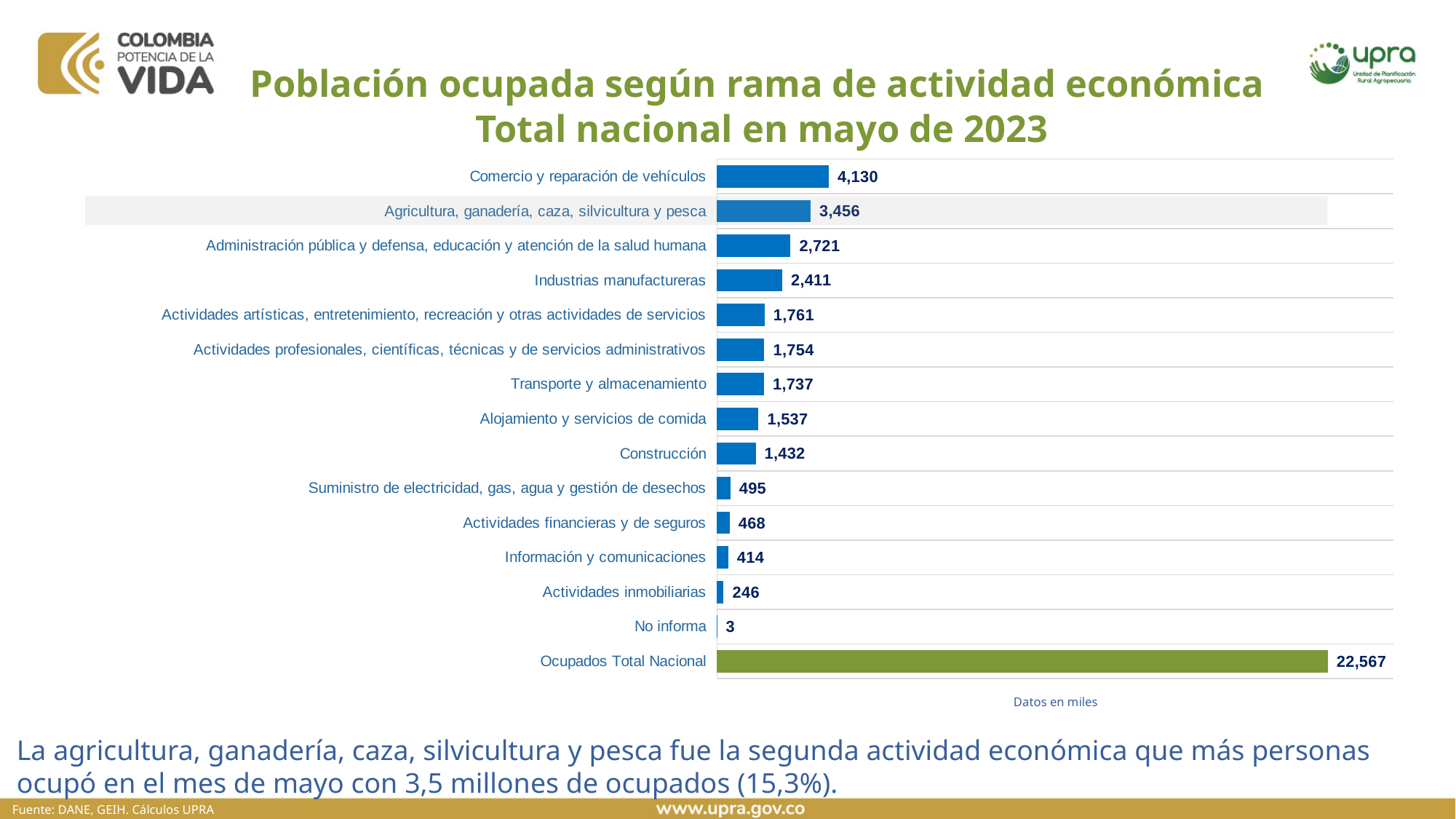
In what units are the data in the chart expressed, according to the note below it? Datos en miles Excluding Ocupados Total Nacional, which economic activity has the highest value? Comercio y reparación de vehículos What is the difference between Administración pública y defensa, educación y atención de la salud humana and Industrias manufactureras? 310 How many bars are shown in the chart? 15 What is the difference between Comercio y reparación de vehículos and Agricultura, ganadería, caza, silvicultura y pesca? 674 What is the value for Comercio y reparación de vehículos? 4,130 What is the value for Agricultura, ganadería, caza, silvicultura y pesca? 3,456 Which is larger, Alojamiento y servicios de comida or Construcción? Alojamiento y servicios de comida What is the value for Ocupados Total Nacional? 22,567 Which category has the lowest value? No informa What is the value for Actividades inmobiliarias? 246 What kind of chart is shown on the slide? Bar chart